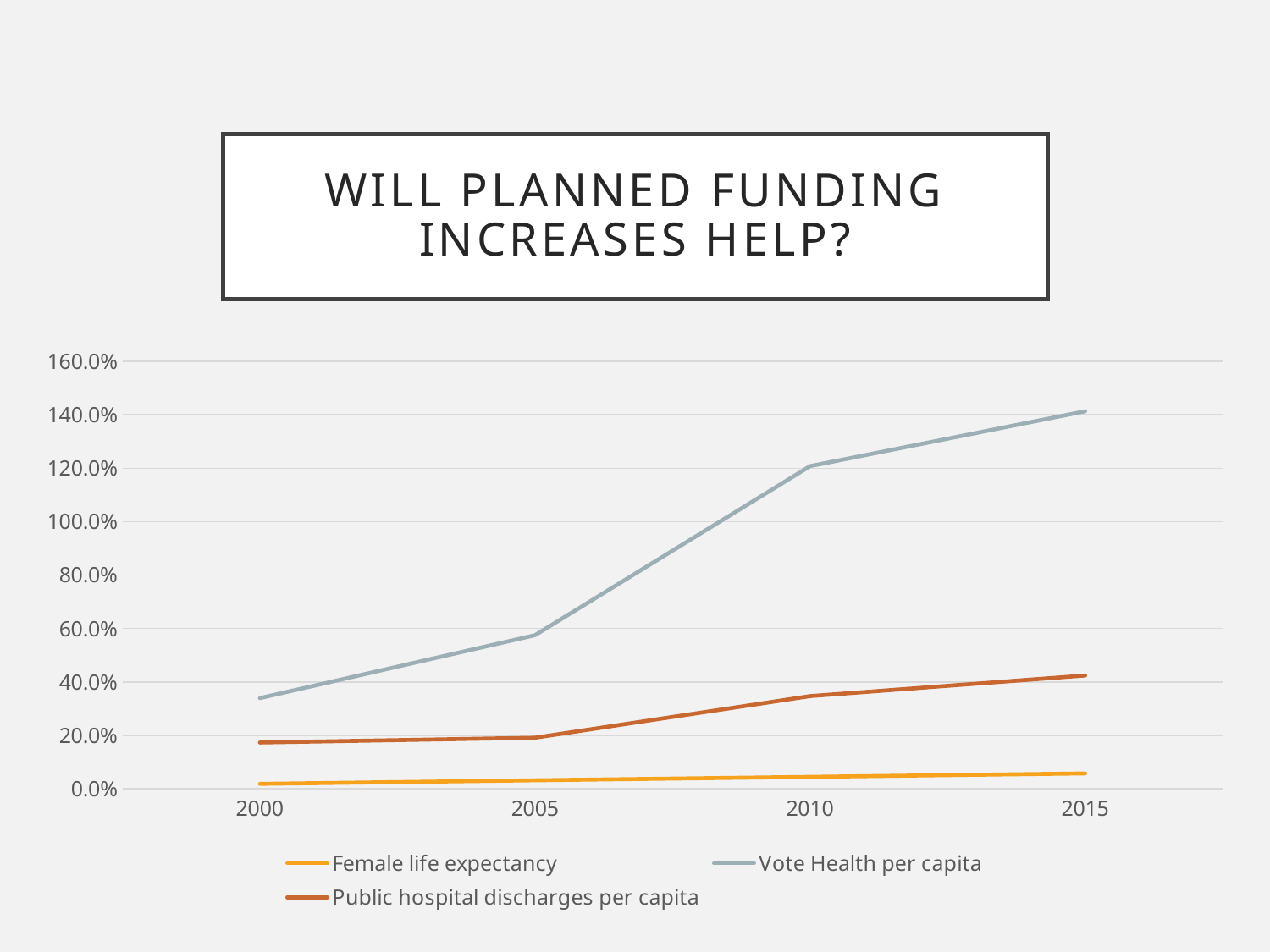
What kind of chart is shown on the slide? line chart Is the value for Vote Health per capita in 2010 greater or less than 100.0%? greater Which series has the highest value in 2015? Vote Health per capita Does the Vote Health per capita line rise or fall from 2000 to 2015? rise Is the value for Public hospital discharges per capita in 2015 greater or less than 20.0%? greater Is the value for Female life expectancy in 2015 greater or less than 20.0%? less How many series does the legend list? 3 What is the title shown above the chart? WILL PLANNED FUNDING INCREASES HELP? How many years are plotted along the x axis? 4 Which series has the lowest value in 2010? Female life expectancy Which is larger in 2010: Vote Health per capita or Public hospital discharges per capita? Vote Health per capita